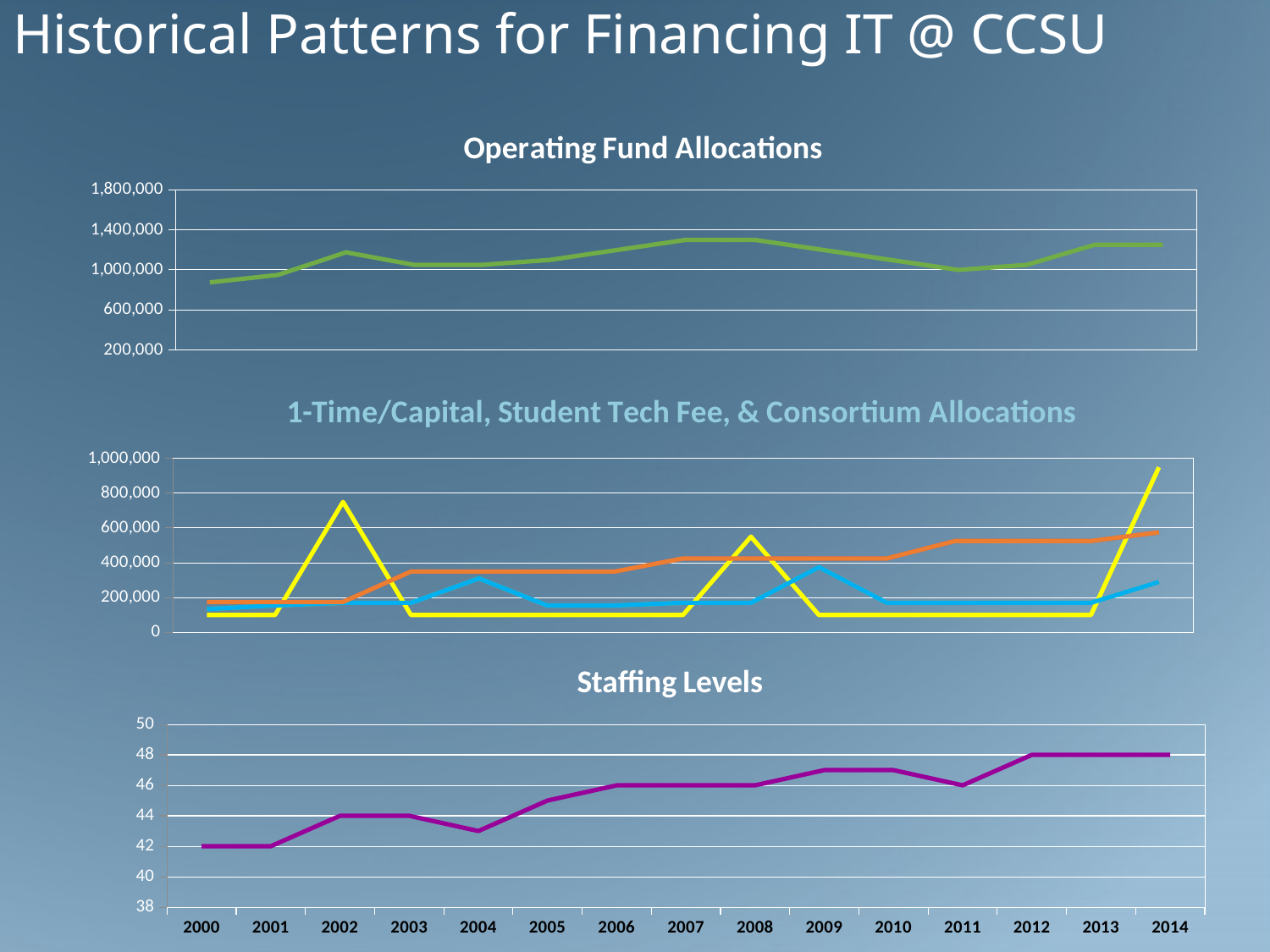
On the Staffing Levels chart, is the value for 2011 greater or less than 48? less On the Staffing Levels chart, what is the staffing level in 2014? 48 On the Operating Fund Allocations chart, is the highest point on the line greater or less than 1,400,000? less How many lines are plotted on the 1-Time/Capital, Student Tech Fee, & Consortium Allocations chart? 3 On the Staffing Levels chart, what is the staffing level in 2002? 44 On the Staffing Levels chart, what is the staffing level in 2006? 46 On the Staffing Levels chart, by how much did the staffing level increase from 2000 to 2014? 6 On the Staffing Levels chart, do staffing levels generally rise or fall from 2000 to 2014? rise What kind of chart is the Operating Fund Allocations chart? line chart On the Staffing Levels chart, what is the staffing level in 2000? 42 How many years are shown on the x axis of the Staffing Levels chart? 15 On the Staffing Levels chart, is the staffing level in 2012 higher or lower than in 2004? 2012 is higher